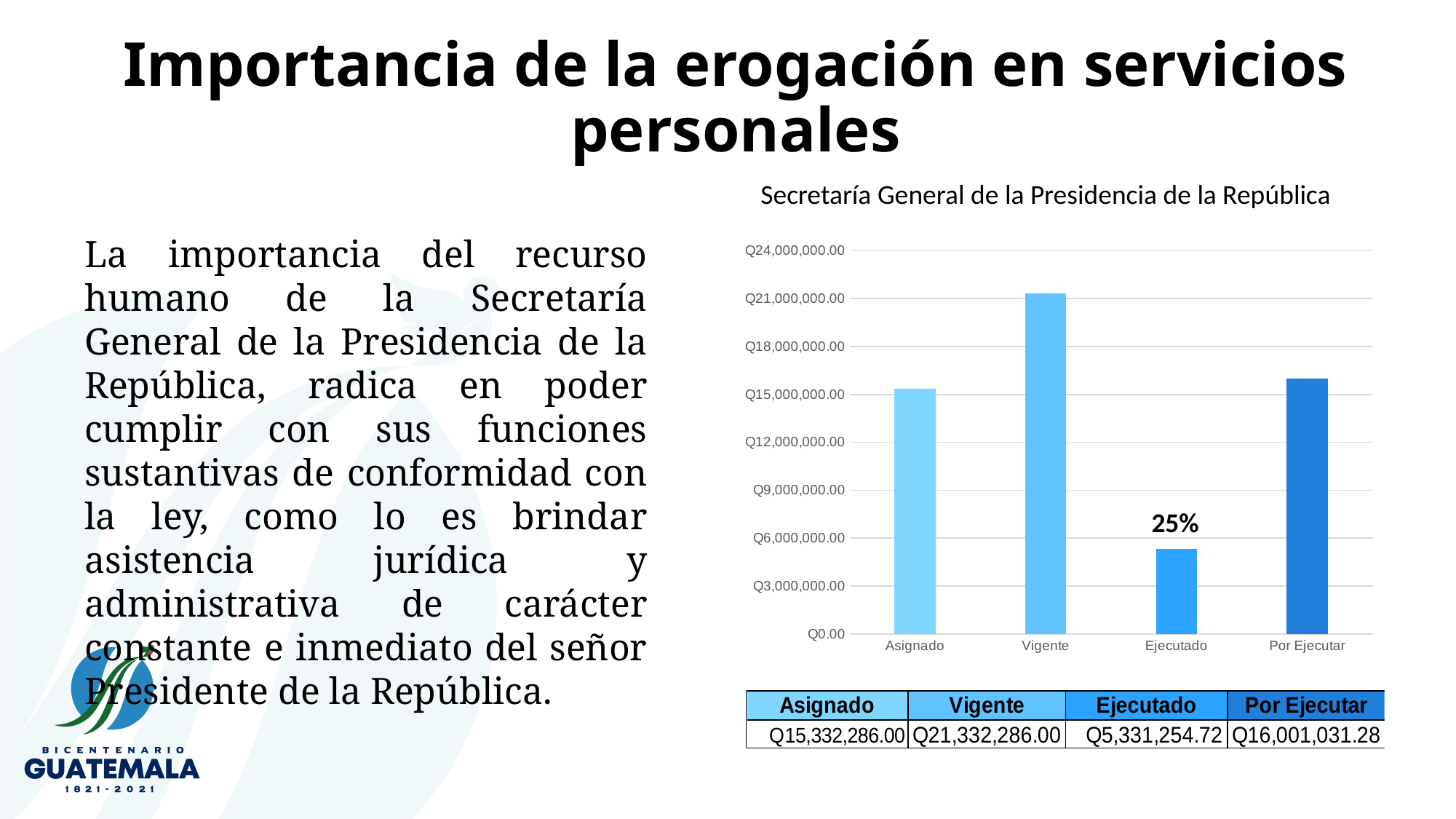
What is the value for Por Ejecutar? Q16,001,031.28 What is the difference between Vigente and Asignado? Q6,000,000.00 What percentage label is shown above the Ejecutado bar? 25% What is the value for Asignado? Q15,332,286.00 Which category has the highest value? Vigente What is the value for Vigente? Q21,332,286.00 What is the value for Ejecutado? Q5,331,254.72 Which is larger, Por Ejecutar or Asignado? Por Ejecutar How many categories are shown on the chart? 4 What kind of chart is shown? Bar chart Which category has the lowest value? Ejecutado What is the difference between Vigente and Ejecutado? Q16,001,031.28